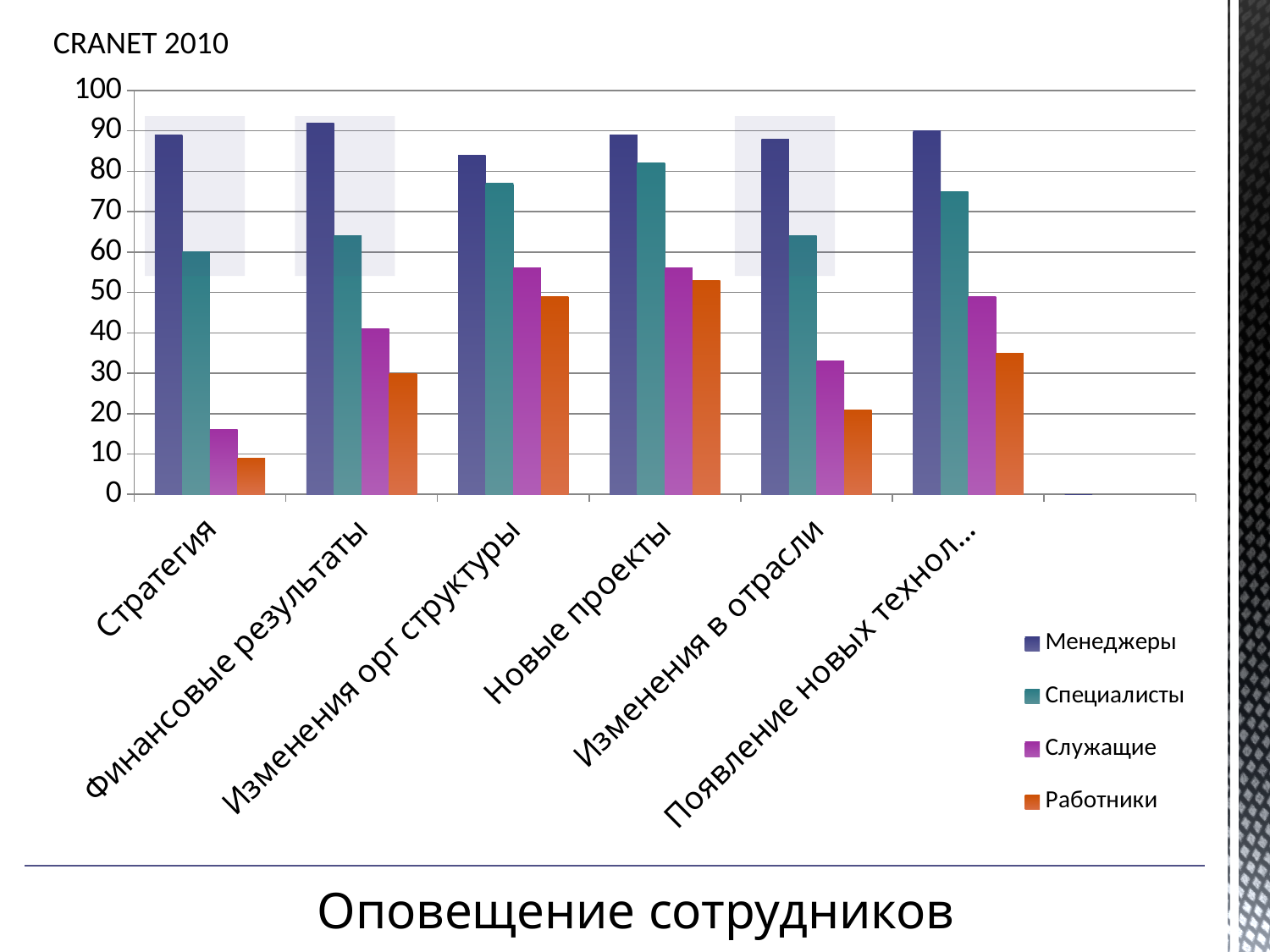
Which is larger: the value for Специалисты in Стратегия or in Изменения орг структуры? Изменения орг структуры How many categories are shown on the x axis? 6 What is the title shown above the chart? CRANET 2010 Which is larger: the value for Служащие in Финансовые результаты or in Изменения в отрасли? Финансовые результаты In which category is the value for Служащие the lowest? Стратегия How many series does the legend list? 4 Is the value for Служащие in the Изменения в отрасли category greater or less than 40? less In which category is the value for Работники the lowest? Стратегия Is the value for Специалисты in the Новые проекты category greater or less than 70? greater Is the value for Работники in the Стратегия category greater or less than 20? less What kind of chart is shown on the slide? bar chart